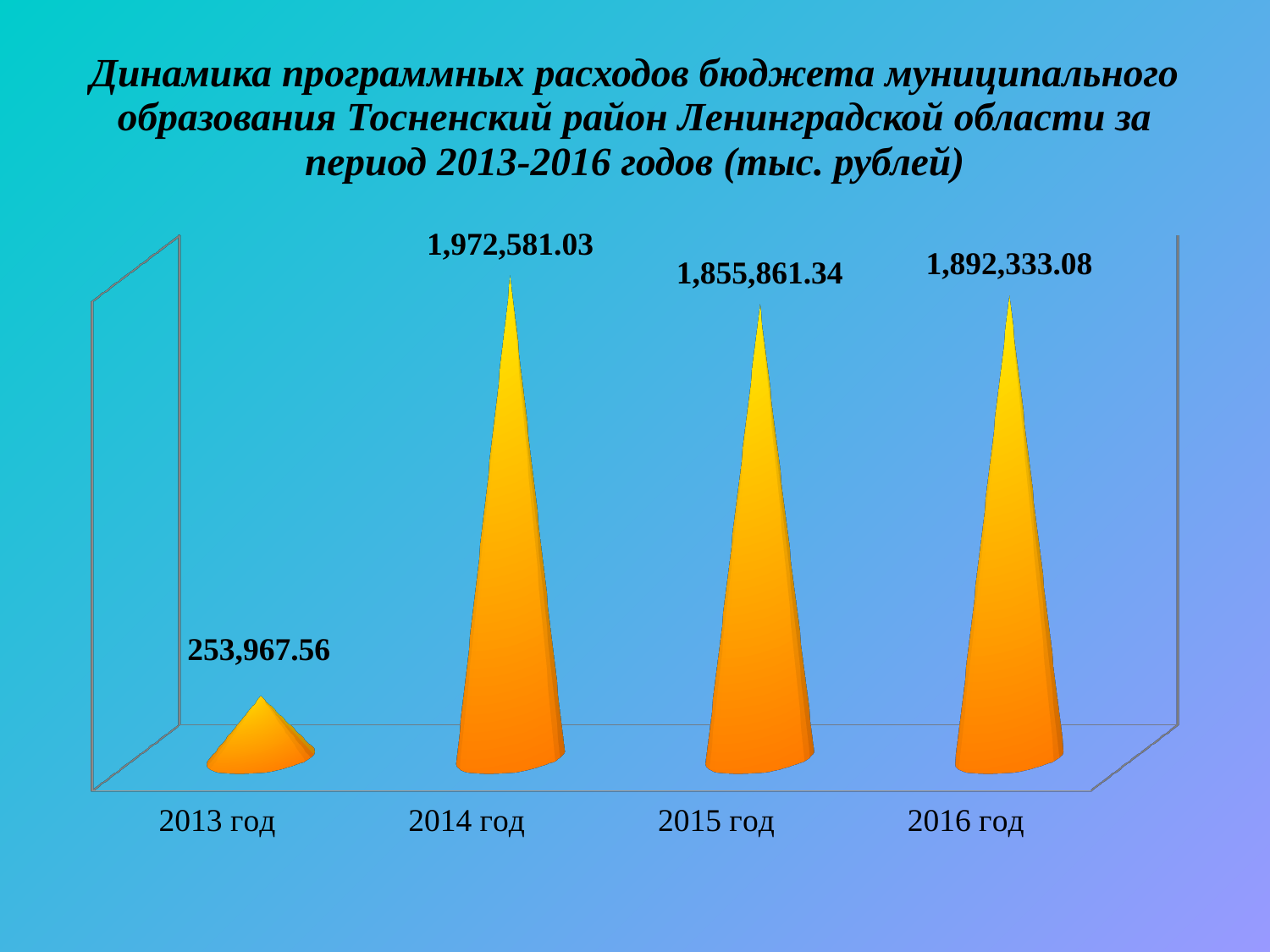
Which year has the lowest value? 2013 год What unit of measurement is stated in the chart title? тыс. рублей What is the value for 2016 год? 1,892,333.08 Which year has the highest value? 2014 год What is the value for 2013 год? 253,967.56 What is the value for 2014 год? 1,972,581.03 What kind of chart is shown on the slide? Bar chart How many years are shown on the chart? 4 Which is larger, the value for 2015 год or 2016 год? 2016 год What is the difference between the values for 2014 год and 2013 год? 1,718,613.47 What is the value for 2015 год? 1,855,861.34 What is the difference between the values for 2016 год and 2015 год? 36,471.74